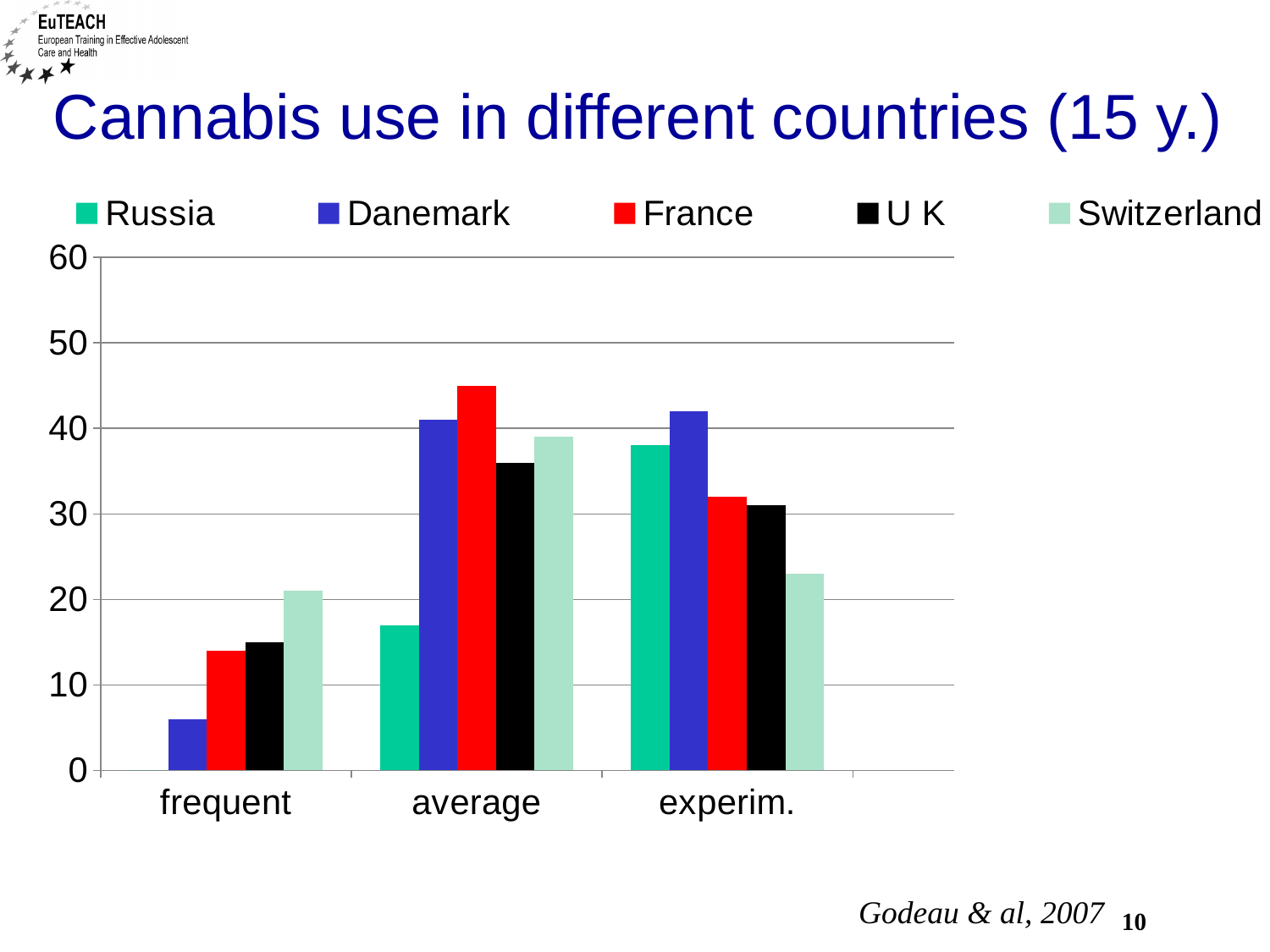
What is the title of the chart? Cannabis use in different countries (15 y.) Which country has the lowest value in the 'average' category? Russia Is the value for Switzerland in the 'experim.' category greater or less than 30? less Which country has the highest value in the 'frequent' category? Switzerland In the 'average' category, which is larger: France or U K? France Which country has the highest value in the 'average' category? France Is the value for Danemark in the 'frequent' category greater or less than 10? less How many series does the legend list? 5 Which country has the lowest value in the 'experim.' category? Switzerland How many categories are shown on the x axis? 3 Is the value for France in the 'average' category greater or less than 40? greater What kind of chart is shown on the slide? bar chart